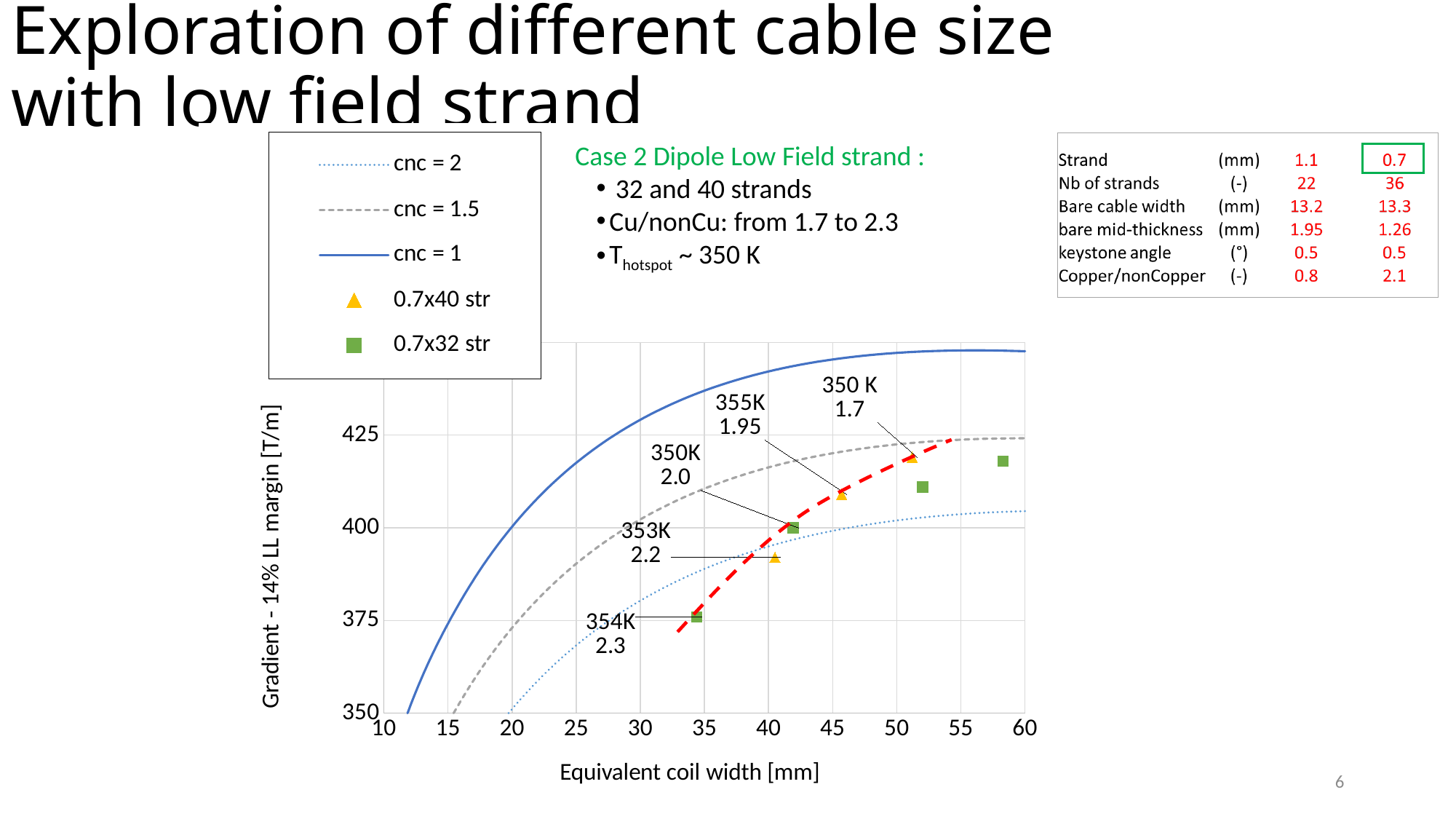
How many 0.7x40 str data points are plotted on the chart? 3 Which of the three cnc curves has the highest gradient at 40 mm equivalent coil width? cnc = 1 What kind of chart is shown on the slide? line chart with scatter points What is the title of the x axis of the chart? Equivalent coil width [mm] Is the value of the 0.7x32 str point near 34 mm equivalent coil width greater or less than 400 T/m? less What colour and shape is the legend marker for the 0.7x32 str series? green square Is the value of the cnc = 1 curve at 60 mm equivalent coil width greater or less than 425 T/m? greater Is the value of the 0.7x40 str point near 51 mm equivalent coil width greater or less than 400 T/m? greater How many series does the chart legend list? 5 Does the cnc = 1 curve rise or fall as the equivalent coil width increases? rise How many 0.7x32 str data points are plotted on the chart? 4 At 30 mm equivalent coil width, which curve is higher: cnc = 1.5 or cnc = 2? cnc = 1.5